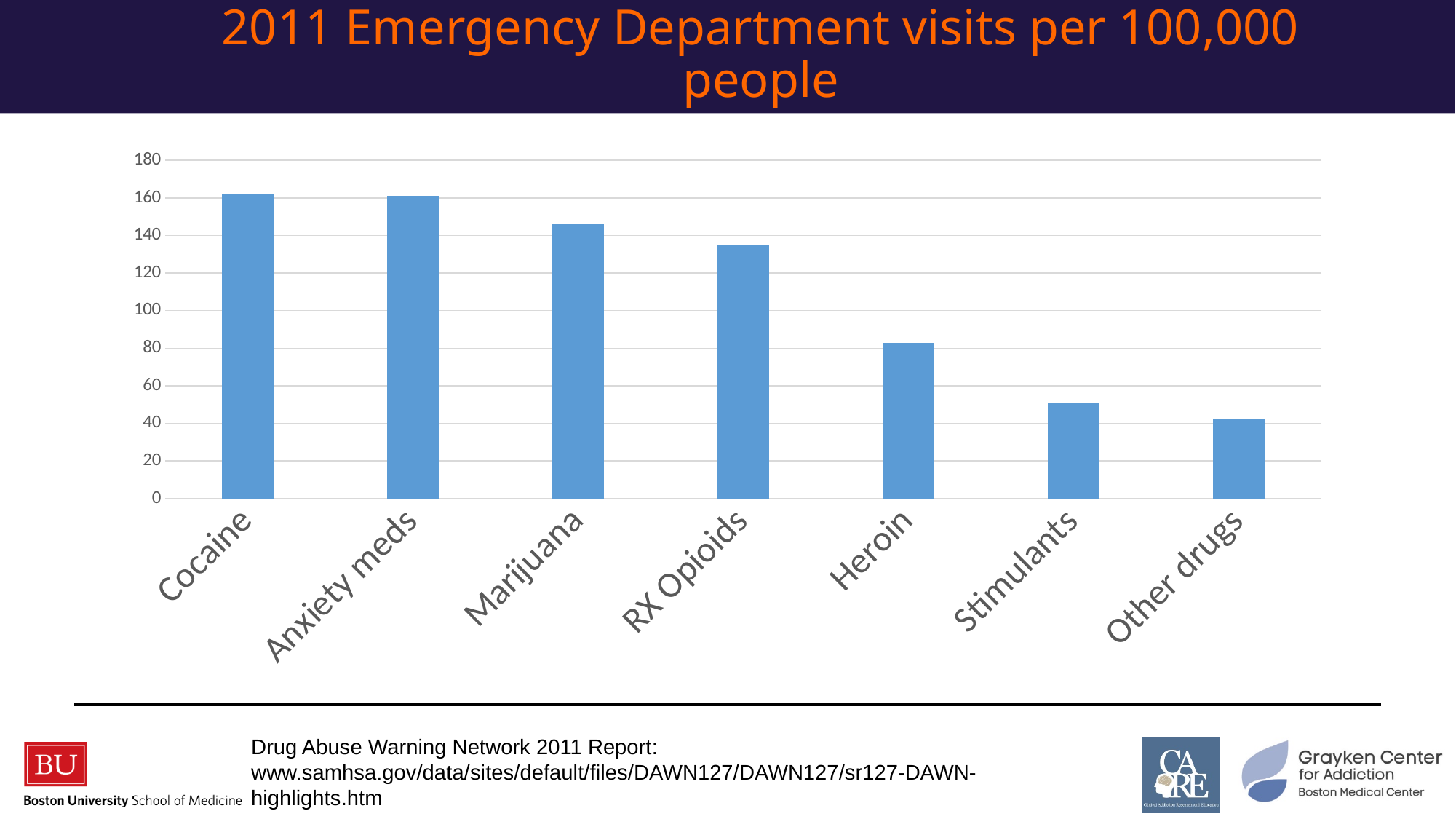
Which category has the lowest number of emergency department visits per 100,000 people? Other drugs Which has more emergency department visits per 100,000 people, Marijuana or RX Opioids? Marijuana Is the value for Cocaine greater or less than 140? greater Is the value for Other drugs greater or less than 60? less Is the value for RX Opioids greater or less than 140? less How many drug categories are shown on the x axis of the chart? 7 Do the bar values rise or fall moving from left to right along the x axis? fall What is the title of the chart on the slide? 2011 Emergency Department visits per 100,000 people What kind of chart is shown on the slide? bar chart Which has more emergency department visits per 100,000 people, Heroin or Stimulants? Heroin